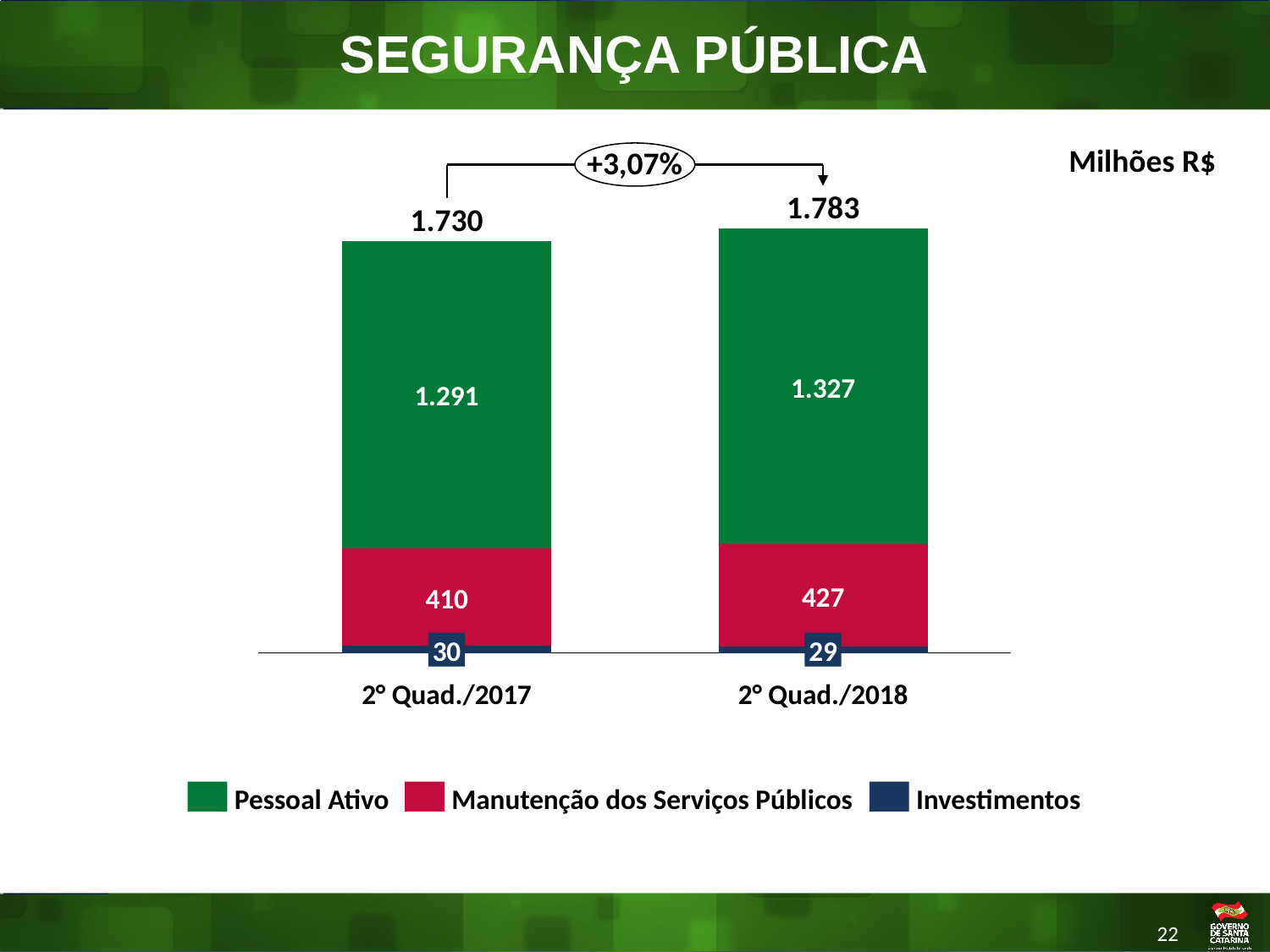
What is the total of the stacked bar for 2° Quad./2017? 1.730 How many series does the legend list? 3 What kind of chart is shown on the slide? Stacked bar chart What is the value of Manutenção dos Serviços Públicos for 2° Quad./2018? 427 What is the value of Pessoal Ativo for 2° Quad./2017? 1.291 What percentage change is shown between the two bars? +3,07% What is the total of the stacked bar for 2° Quad./2018? 1.783 Which period has the larger value for Manutenção dos Serviços Públicos, 2° Quad./2017 or 2° Quad./2018? 2° Quad./2018 How many categories are shown on the x axis? 2 What is the difference between the Pessoal Ativo values for 2° Quad./2018 and 2° Quad./2017? 36 What is the value of Investimentos for 2° Quad./2017? 30 Which series has the lowest value in 2° Quad./2018? Investimentos